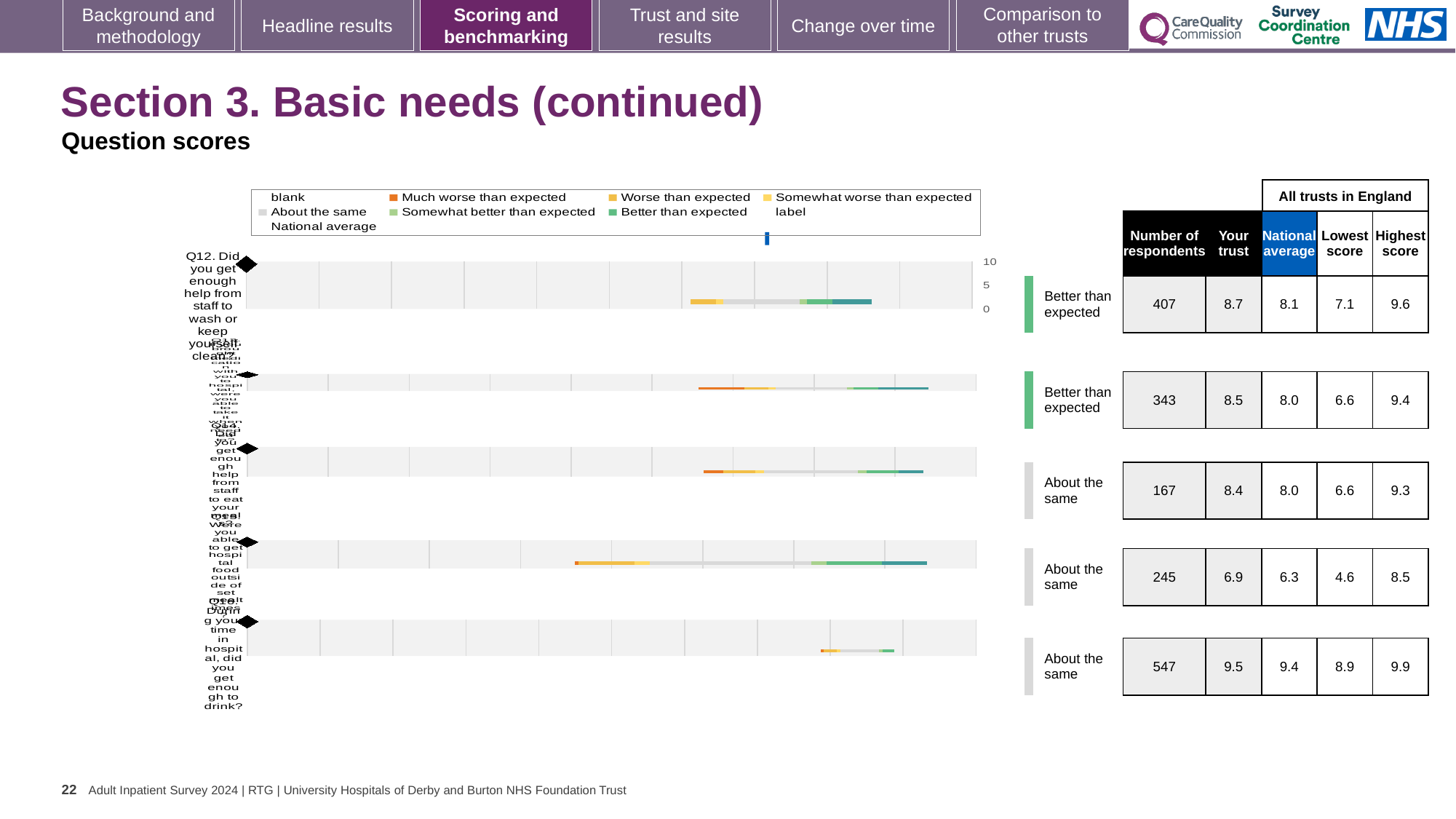
Which legend entry is shown in orange? Much worse than expected What kind of chart is used to show the question scores on this slide? bar chart What is the national average score for Q16 (did you get enough to drink)? 9.4 Which question has the highest 'Your trust' score? Q16 How many respondents answered Q15 (hospital food outside of set meal times)? 245 Which question has the lowest 'Your trust' score? Q15 How many entries does the chart legend list? 9 What benchmark category is shown for Q12? Better than expected How many survey questions (rows) are plotted in the chart? 5 What is the 'Your trust' score for Q12 (help from staff to wash or keep yourself clean)? 8.7 Is the trust score for Q14 (help from staff to eat your meals) higher or lower than the national average? higher What is the difference between the trust score and the national average for Q15? 0.6